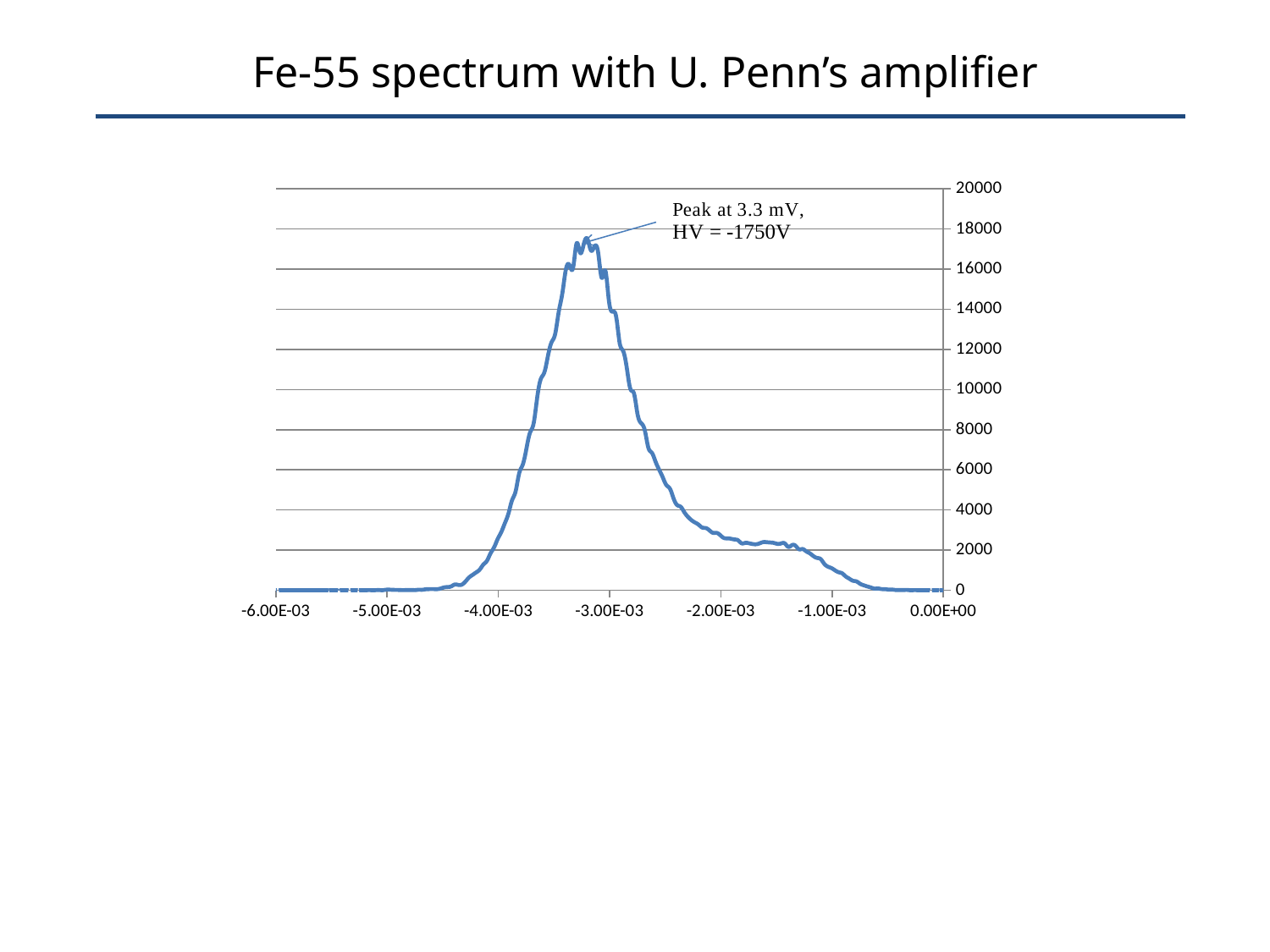
Between which two x-axis tick labels does the peak of the curve occur? -4.00E-03 and -3.00E-03 Is the maximum value of the curve greater or less than 18000? less Is the value of the curve at -3.00E-03 greater or less than 12000? greater Is the maximum value of the curve greater or less than 16000? greater What kind of chart is shown on the slide? line chart According to the annotation on the chart, at what voltage is the peak? 3.3 mV Does the curve rise or fall as x goes from -3.00E-03 to -1.00E-03? fall What HV value is given in the chart annotation? -1750V What is the title of the slide? Fe-55 spectrum with U. Penn's amplifier What is the highest tick value shown on the y axis? 20000